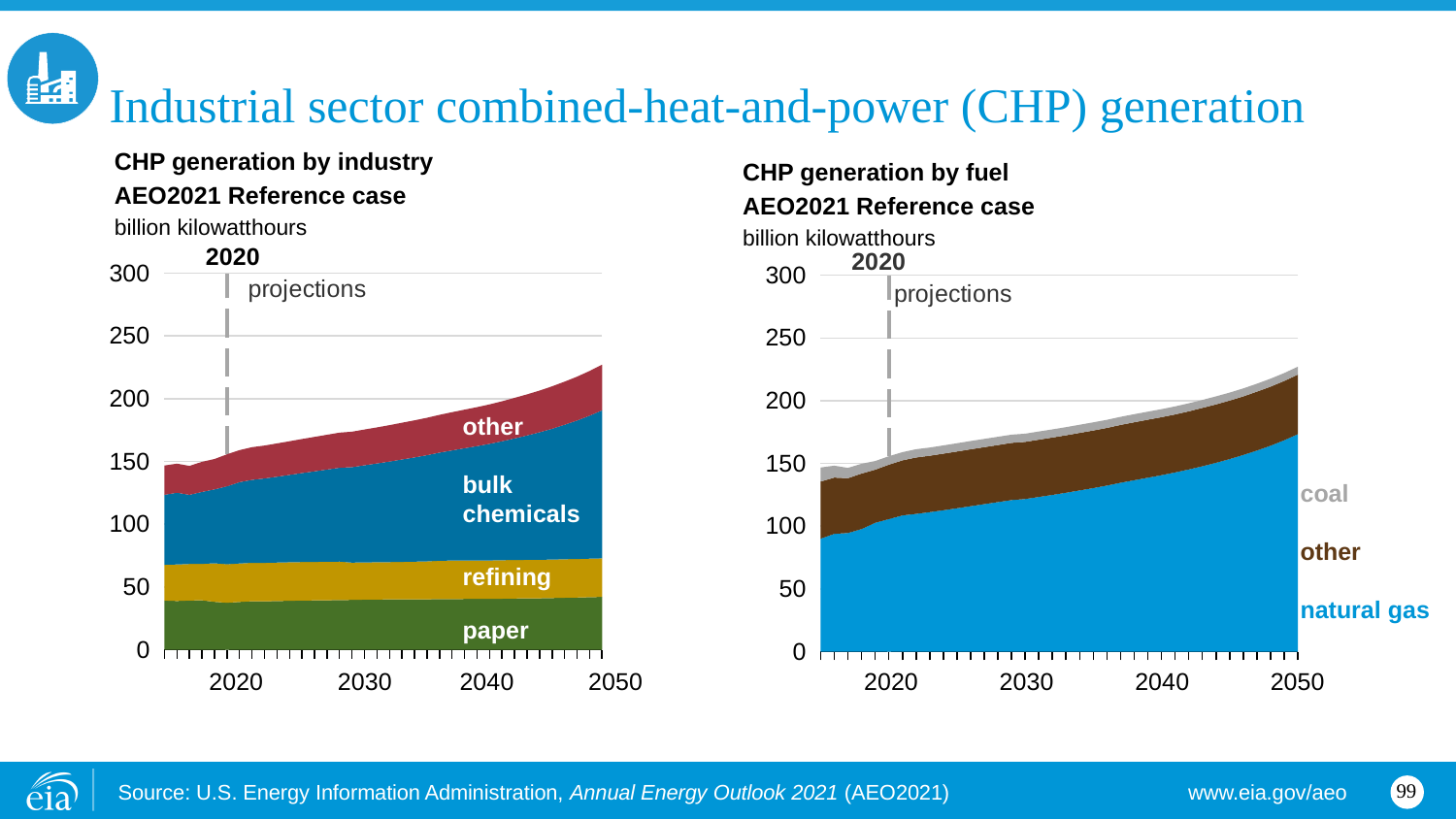
In the 'CHP generation by fuel' chart, does total CHP generation rise or fall from 2020 to 2050? rise In the 'CHP generation by industry' chart, is CHP generation from paper in 2050 greater or less than 50 billion kilowatthours? less Which AEO2021 case do both charts show? Reference case In the 'CHP generation by fuel' chart, is natural gas CHP generation in 2050 greater or less than 150 billion kilowatthours? greater How many fuel series are shown in the 'CHP generation by fuel' chart? 3 In the 'CHP generation by industry' chart, is total CHP generation in 2050 greater or less than 200 billion kilowatthours? greater In the 'CHP generation by fuel' chart, which fuel accounts for the smallest share of CHP generation? coal What kind of chart is the 'CHP generation by industry' chart? stacked area chart What unit is used on the y axis of both charts? billion kilowatthours In the 'CHP generation by fuel' chart, which fuel accounts for the largest share of CHP generation? natural gas In the 'CHP generation by industry' chart, which industry accounts for the largest share of CHP generation? bulk chemicals How many industry series are shown in the 'CHP generation by industry' chart? 4